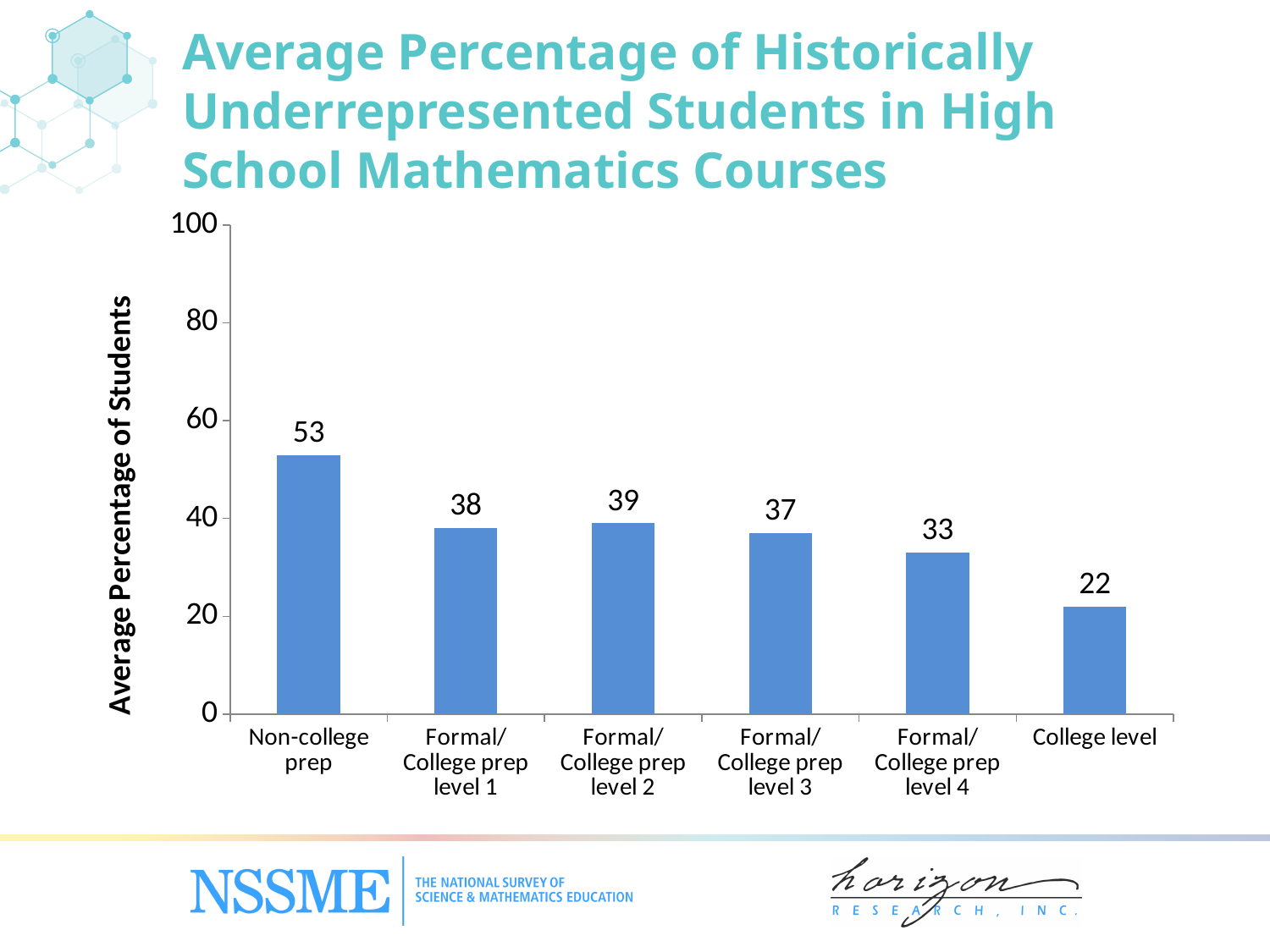
What is the difference between the values for Formal/College prep level 1 and Formal/College prep level 4? 5 What is the label of the vertical axis? Average Percentage of Students Which course category has the lowest average percentage of historically underrepresented students? College level How many course categories are shown on the chart? 6 What is the average percentage of historically underrepresented students in Non-college prep mathematics courses? 53 What kind of chart is shown on the slide? Bar chart What is the difference between the values for Non-college prep and College level? 31 What is the value shown for College level courses? 22 What is the value shown for Formal/College prep level 4? 33 Which course category has the highest average percentage of historically underrepresented students? Non-college prep Which is larger, the value for Formal/College prep level 3 or the value for Formal/College prep level 4? Formal/College prep level 3 Is the value for Non-college prep greater or less than 40? greater